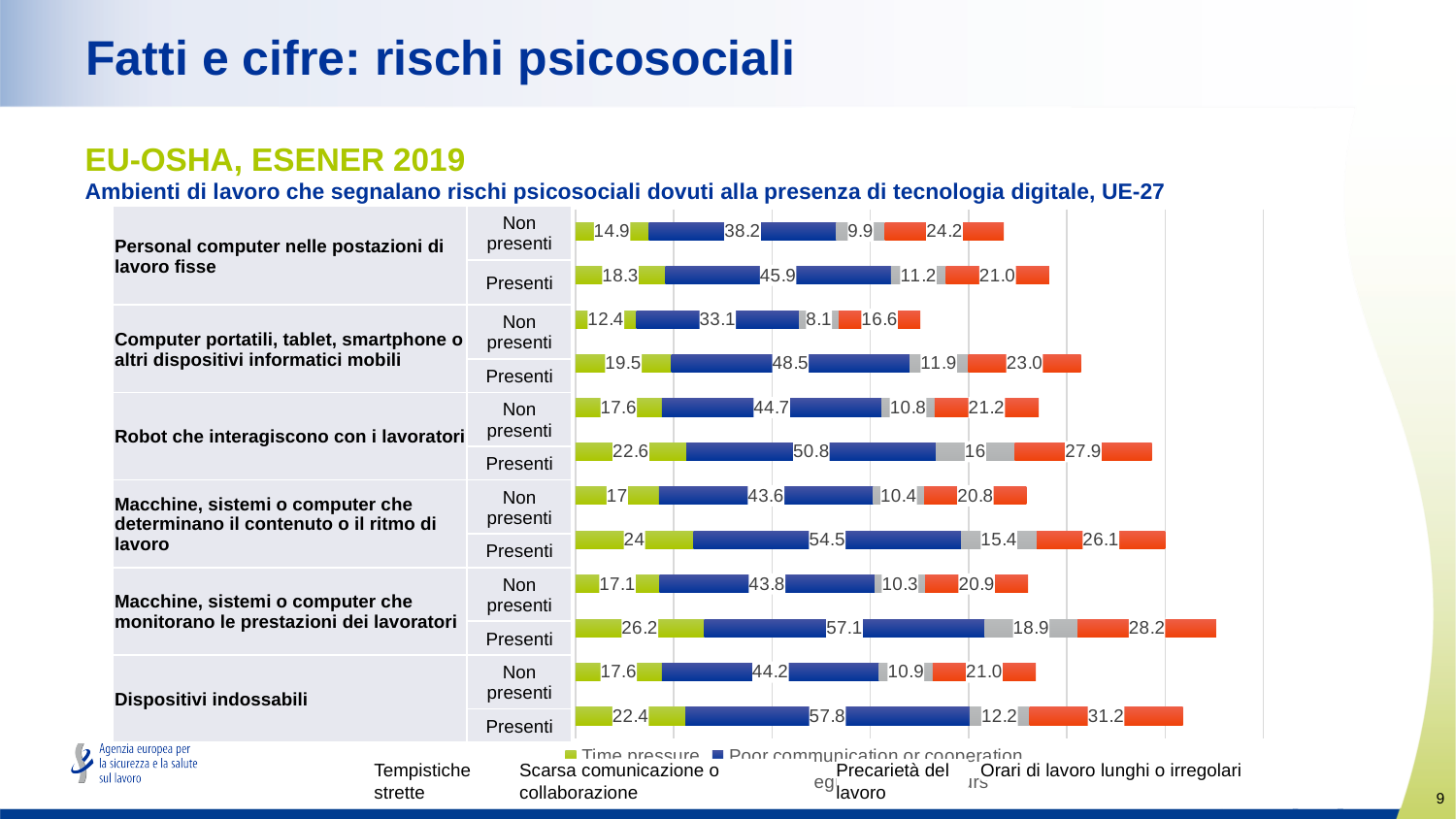
Which bar has the lowest value for Tempistiche strette? Computer portatili, tablet, smartphone o altri dispositivi informatici mobili, Non presenti (12.4) Which bar has the highest value for Scarsa comunicazione o collaborazione? Dispositivi indossabili, Presenti (57.8) What kind of chart is shown on the slide? Stacked bar chart How many bars are plotted in the chart? 12 What is the value for Scarsa comunicazione o collaborazione for 'Personal computer nelle postazioni di lavoro fisse', Presenti? 45.9 How many series does the chart's legend list? 4 What is the value for Orari di lavoro lunghi o irregolari for 'Dispositivi indossabili', Presenti? 31.2 What is the value for Tempistiche strette for 'Robot che interagiscono con i lavoratori', Presenti? 22.6 For 'Personal computer nelle postazioni di lavoro fisse', is the Orari di lavoro lunghi o irregolari value larger for Non presenti or Presenti? Non presenti What is the value for Precarietà del lavoro for 'Computer portatili, tablet, smartphone o altri dispositivi informatici mobili', Non presenti? 8.1 What is the total of the stacked bar for 'Dispositivi indossabili', Presenti? 123.6 What is the difference in Tempistiche strette between Presenti and Non presenti for 'Macchine, sistemi o computer che monitorano le prestazioni dei lavoratori'? 9.1